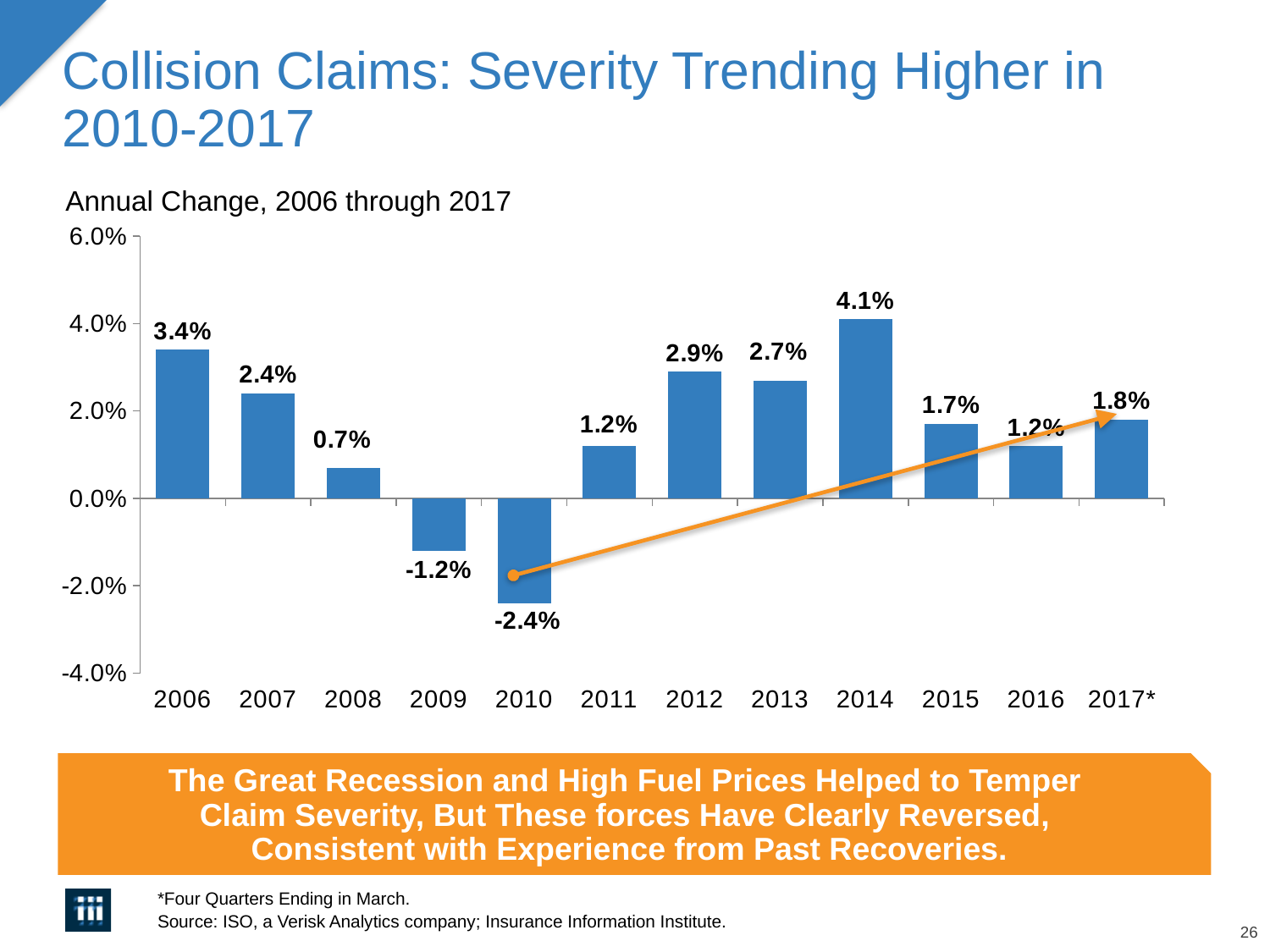
Which year has the lowest annual change? 2010 What is the value shown for 2017*? 1.8% Is the value for 2009 greater or less than 0.0%? less What is the subtitle printed above the chart? Annual Change, 2006 through 2017 How many years are shown on the x axis? 12 What kind of chart is shown on the slide? bar chart Which year has the highest annual change? 2014 What is the difference between the 2014 value and the 2015 value? 2.4 percentage points Which is larger, the value for 2006 or the value for 2012? 2006 What is the annual change in collision claim severity for 2014? 4.1% What is the annual change shown for 2010? -2.4% Do the values rise or fall from 2014 to 2016? fall